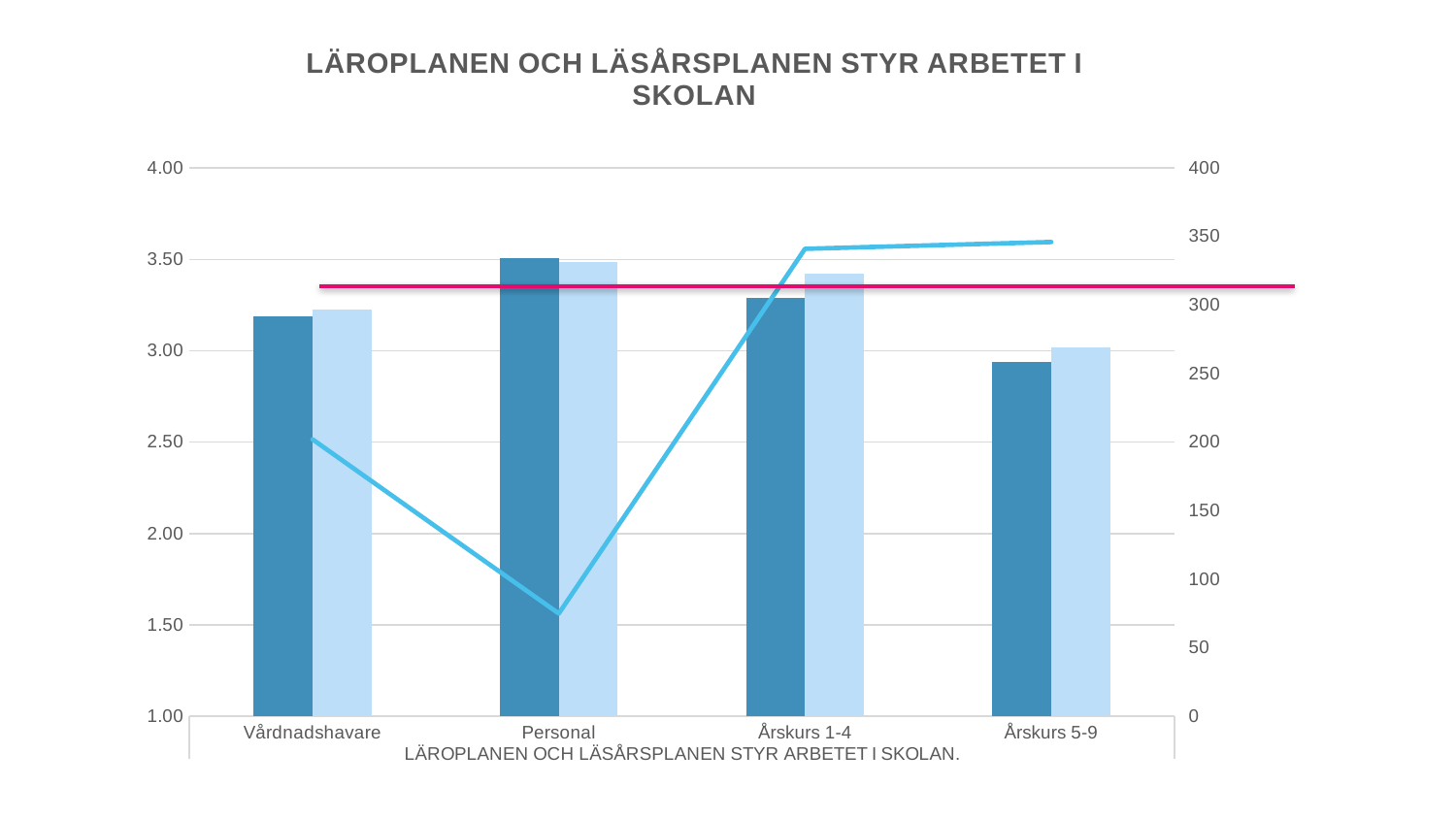
Which dark blue bar is taller, Årskurs 1-4 or Årskurs 5-9? Årskurs 1-4 Which category has the shortest light blue bar? Årskurs 5-9 Which category has the shortest dark blue bar? Årskurs 5-9 Which category has the tallest dark blue bar? Personal How many categories are shown on the x axis of the chart? 4 Is the dark blue bar for Vårdnadshavare greater or less than 3.00 on the left axis? greater What kind of chart is shown on the slide? A combination of a bar chart and a line chart Is the light blue line value for Personal greater or less than 100 on the right axis? less Does the light blue line rise or fall between Personal and Årskurs 1-4? rise Is the light blue line value for Årskurs 5-9 greater or less than 300 on the right axis? greater Which category has the tallest light blue bar? Personal